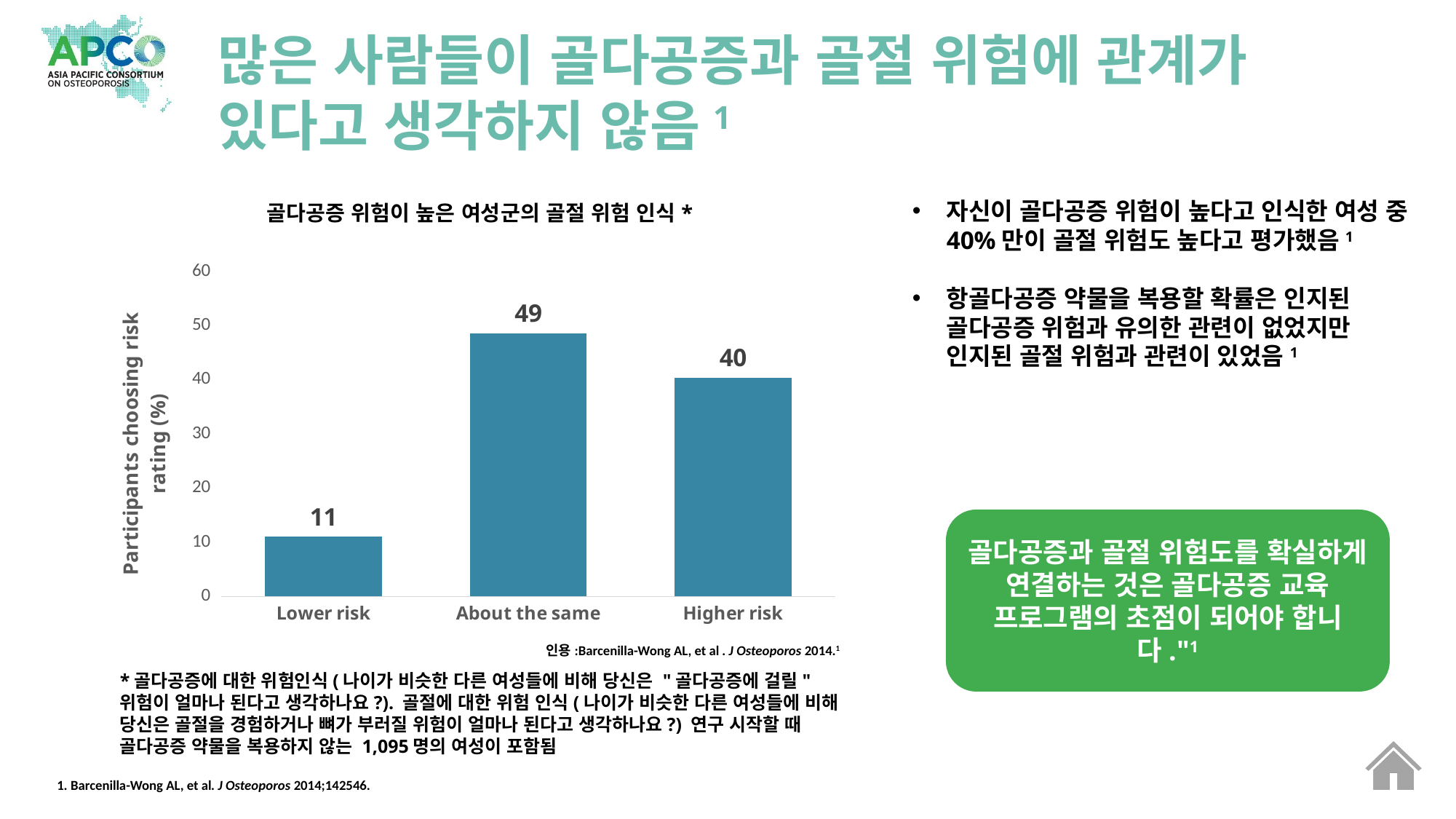
What is the difference between the values for "Higher risk" and "Lower risk"? 29 What is the label of the y axis? Participants choosing risk rating (%) Which is larger, the value for "Lower risk" or the value for "Higher risk"? Higher risk What is the value for "About the same"? 49 Which category has the lowest value? Lower risk What kind of chart is shown on the slide? bar chart What is the value for "Higher risk"? 40 How many categories are shown on the x axis? 3 Which category has the highest value? About the same Is the value for "About the same" greater or less than 40? greater What is the value for "Lower risk"? 11 What is the difference between the values for "About the same" and "Higher risk"? 9